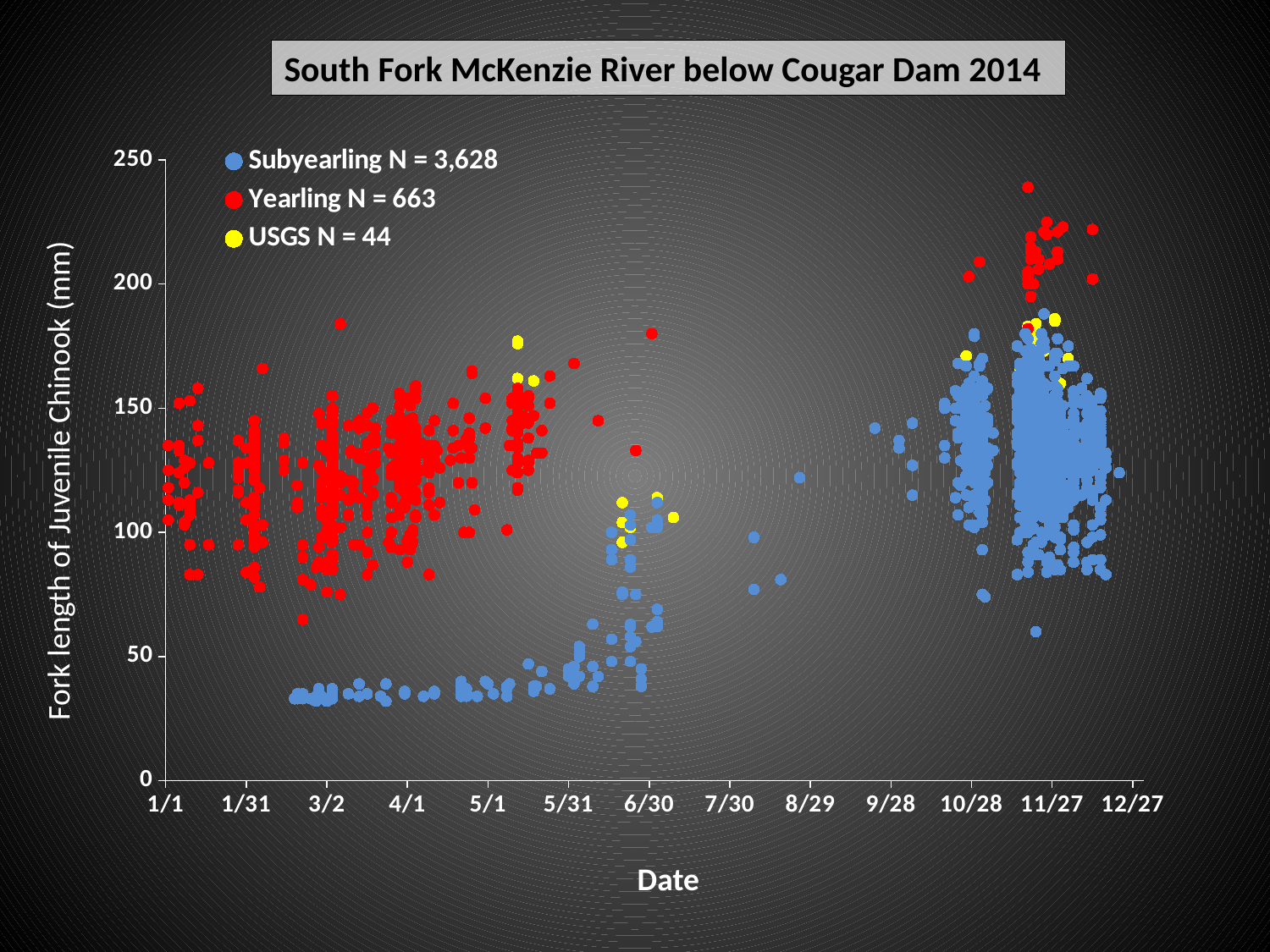
Are the Subyearling fork lengths plotted in early March greater or less than 50 mm? less What is the sample size (N) shown in the legend for the USGS series? 44 Which series has the smallest N according to the legend? USGS How many series does the legend list? 3 What is the sample size (N) shown in the legend for the Subyearling series? 3,628 What is the title of the chart? South Fork McKenzie River below Cougar Dam 2014 What kind of chart is shown on the slide? scatter chart What is the sample size (N) shown in the legend for the Yearling series? 663 Which series has the largest N according to the legend? Subyearling Do the Subyearling fork lengths rise or fall from early March to late June? rise What is the difference between the N for Subyearling and the N for Yearling shown in the legend? 2,965 Is the highest Yearling point plotted in late November greater or less than 200 mm? greater